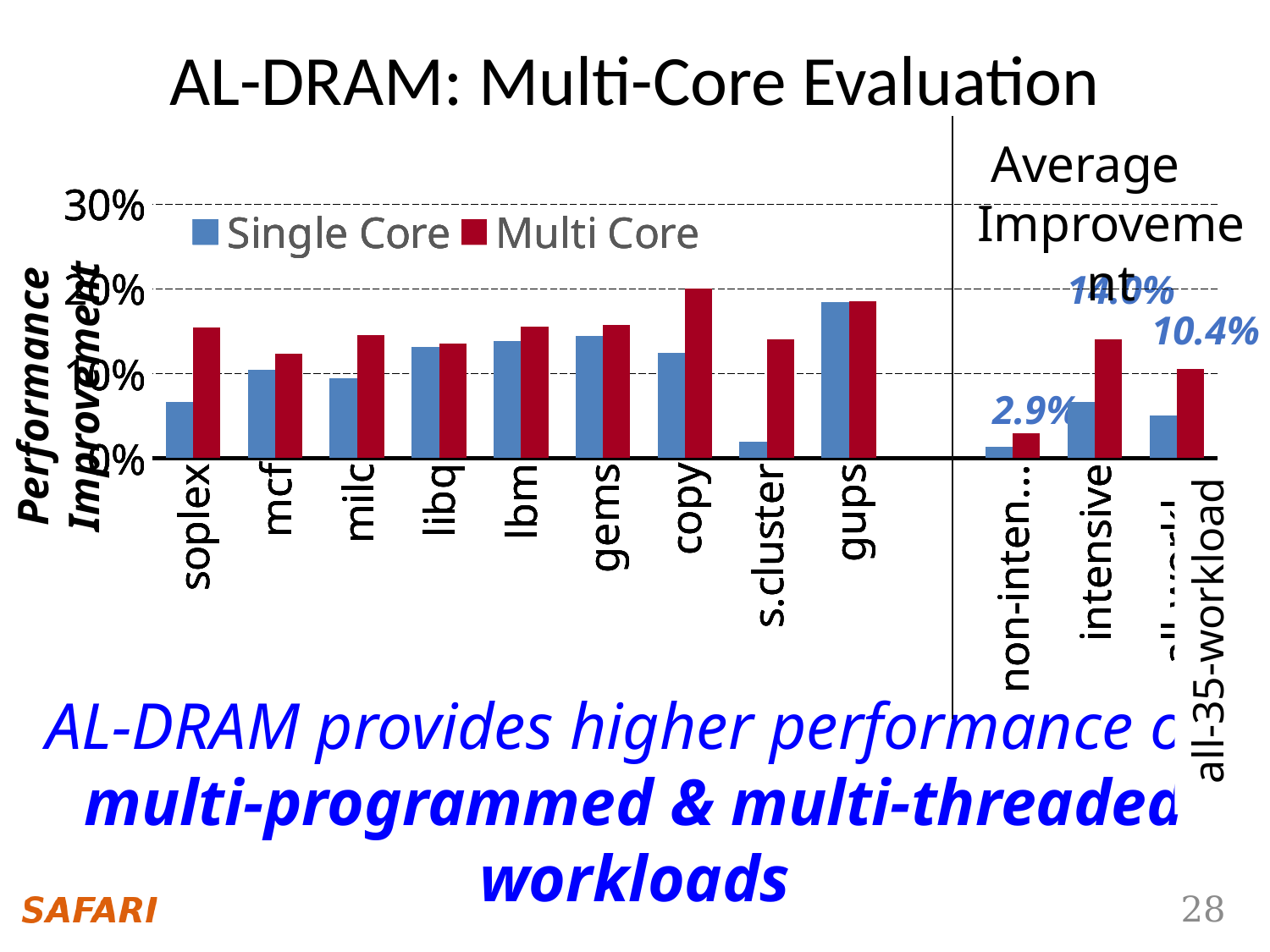
What is the labelled Multi Core performance improvement for all-35-workload? 10.4% Is the Single Core value for s.cluster greater or less than 10%? less Is the Multi Core value for gups greater or less than 10%? greater What is the labelled Multi Core performance improvement for the non-intensive (non-inten...) category? 2.9% Among the nine individual benchmarks to the left of the divider, which has the highest Single Core value? gups Is the Multi Core value for copy greater or less than 10%? greater How many series does the legend list? 2 For soplex, which series has the larger value, Single Core or Multi Core? Multi Core What kind of chart is shown on the slide? bar chart Among the nine individual benchmarks to the left of the divider, which has the lowest Single Core value? s.cluster What are the two series named in the legend? Single Core and Multi Core What is the title of the chart on the slide? AL-DRAM: Multi-Core Evaluation